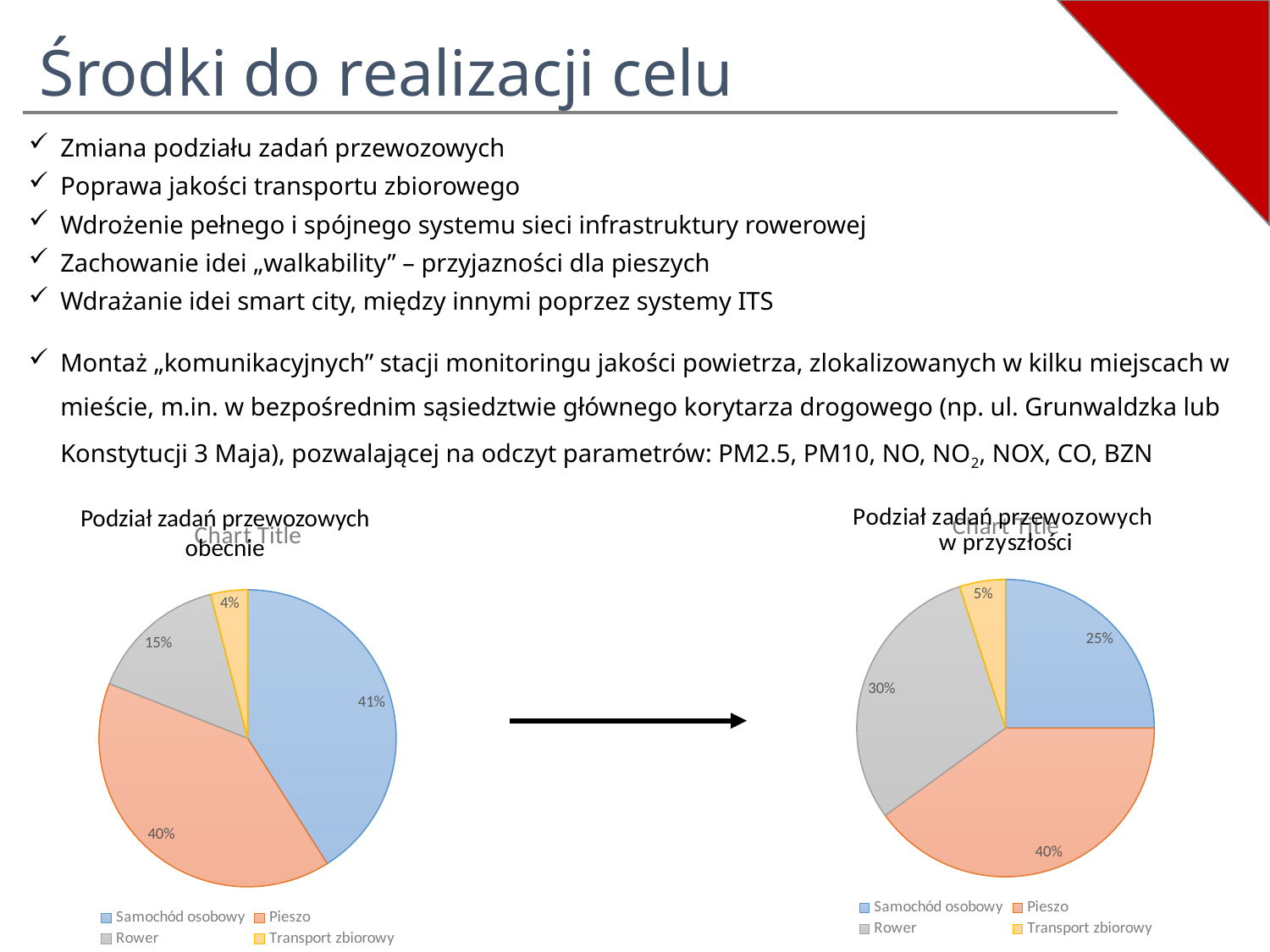
In the left chart (Podział zadań przewozowych obecnie), which colour represents Pieszo? Orange In the left chart (Podział zadań przewozowych obecnie), what share does Rower have? 15% In the right chart (Podział zadań przewozowych w przyszłości), what share does Samochód osobowy have? 25% In the right chart (Podział zadań przewozowych w przyszłości), what share does Rower have? 30% What type of chart is used for Podział zadań przewozowych w przyszłości? Pie chart In the right chart (Podział zadań przewozowych w przyszłości), which is larger: the share for Rower or the share for Samochód osobowy? Rower In the right chart (Podział zadań przewozowych w przyszłości), which category has the largest share? Pieszo In the left chart (Podział zadań przewozowych obecnie), what share does Samochód osobowy have? 41% In the left chart (Podział zadań przewozowych obecnie), which category has the smallest share? Transport zbiorowy How many categories does the legend of the left chart (Podział zadań przewozowych obecnie) list? 4 In the left chart (Podział zadań przewozowych obecnie), what share does Transport zbiorowy have? 4% What is the difference between the Samochód osobowy share in the left chart (obecnie) and in the right chart (w przyszłości)? 16 percentage points